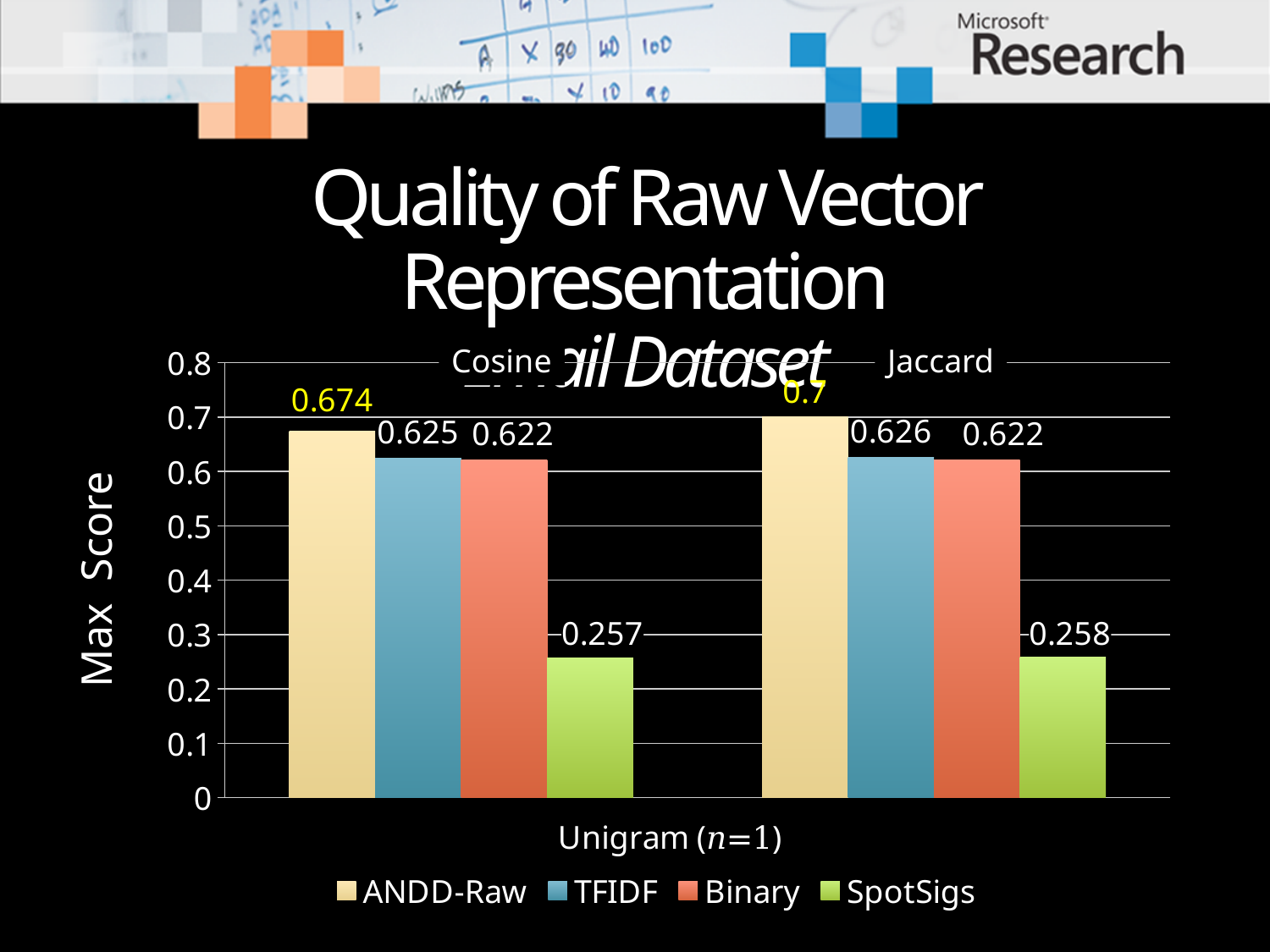
Which series has the lowest value in the Cosine group? SpotSigs Is the value for SpotSigs in the Cosine group greater or less than 0.3? less How many series does the legend list? 4 What is the value for Binary in the Cosine group? 0.622 What is the value for SpotSigs in the Jaccard group? 0.258 What kind of chart is shown on the slide? bar chart What is the value for ANDD-Raw in the Cosine group? 0.674 What is the label on the vertical axis of the chart? Max Score What is the value for TFIDF in the Jaccard group? 0.626 What is the difference between the ANDD-Raw values for Jaccard and Cosine? 0.026 Which is larger: the ANDD-Raw value for Cosine or the TFIDF value for Cosine? ANDD-Raw value for Cosine Which series has the highest value in the Jaccard group? ANDD-Raw